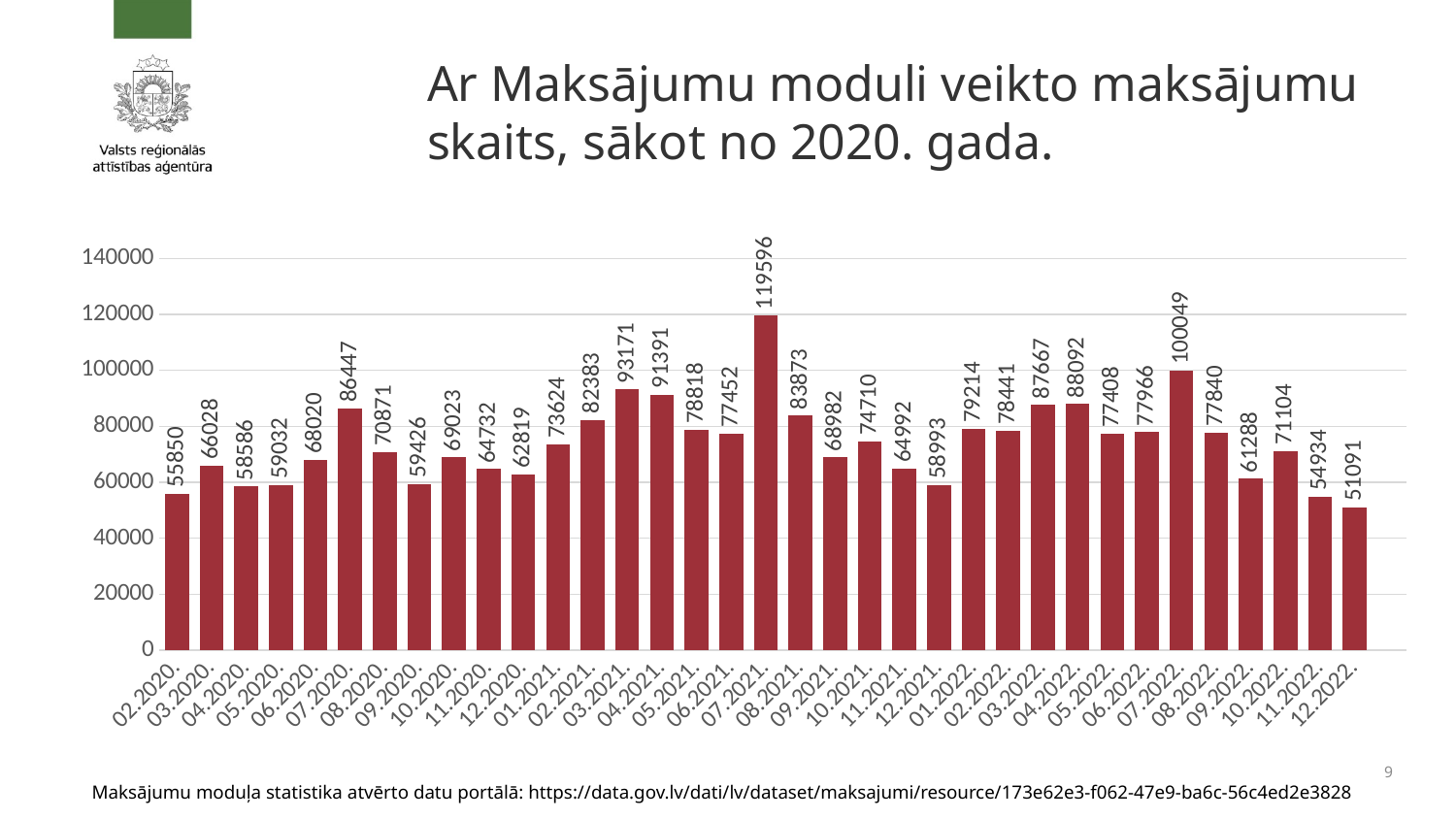
Which is larger, the value for 07.2020 or the value for 07.2022? 07.2022 What is the value for 07.2021? 119596 How many months are shown on the x axis? 35 What is the value for 12.2022? 51091 Is the value for 12.2022 greater or less than 60000? less Which month has the highest value? 07.2021 Do the values rise or fall from 01.2021 to 03.2021? rise What is the difference between the values for 07.2021 and 07.2022? 19547 What kind of chart is shown on the slide? bar chart Which month has the lowest value? 12.2022 What is the difference between the values for 03.2021 and 04.2021? 1780 What is the value for 07.2020? 86447